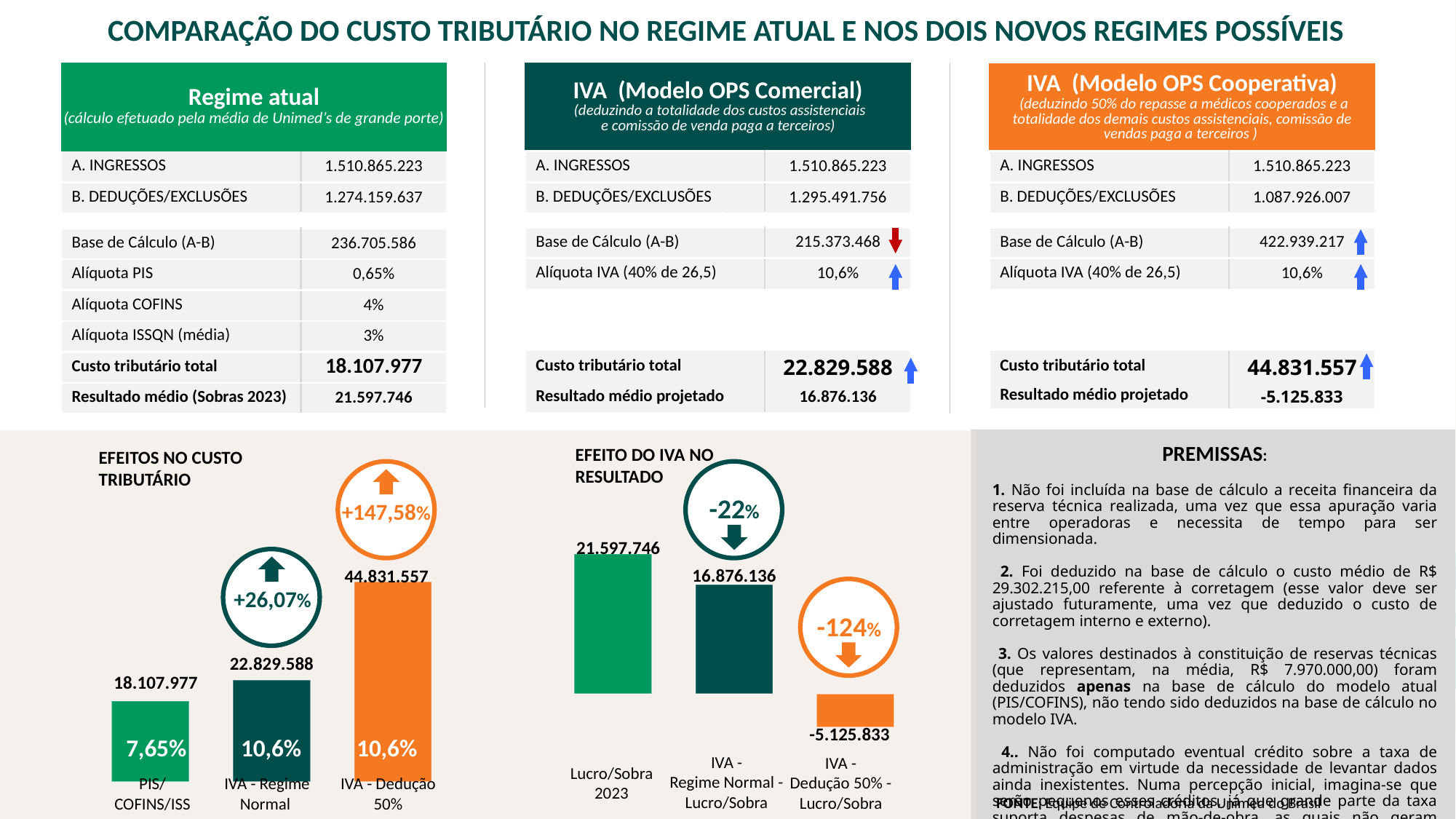
In the 'EFEITOS NO CUSTO TRIBUTÁRIO' chart, what is the difference between 'IVA - Dedução 50%' and 'IVA - Regime Normal'? 22.001.969 In the 'EFEITOS NO CUSTO TRIBUTÁRIO' chart, what is the value for 'PIS/COFINS/ISS'? 18.107.977 In the 'EFEITO DO IVA NO RESULTADO' chart, what is the value for 'IVA - Dedução 50% - Lucro/Sobra'? -5.125.833 What type of chart is 'EFEITO DO IVA NO RESULTADO'? Bar chart In the 'EFEITOS NO CUSTO TRIBUTÁRIO' chart, which category has the lowest value? PIS/COFINS/ISS In the 'EFEITOS NO CUSTO TRIBUTÁRIO' chart, what is the value for 'IVA - Regime Normal'? 22.829.588 In the 'EFEITOS NO CUSTO TRIBUTÁRIO' chart, which category has the highest value? IVA - Dedução 50% In the 'EFEITO DO IVA NO RESULTADO' chart, how many bars are plotted? 3 In the 'EFEITO DO IVA NO RESULTADO' chart, what is the value for 'Lucro/Sobra 2023'? 21.597.746 In the 'EFEITO DO IVA NO RESULTADO' chart, what is the difference between 'Lucro/Sobra 2023' and 'IVA - Regime Normal - Lucro/Sobra'? 4.721.610 In the 'EFEITOS NO CUSTO TRIBUTÁRIO' chart, what percentage is printed inside the 'PIS/COFINS/ISS' bar? 7,65% In the 'EFEITOS NO CUSTO TRIBUTÁRIO' chart, what percentage change is shown in the circle above the 'IVA - Dedução 50%' bar? +147,58%